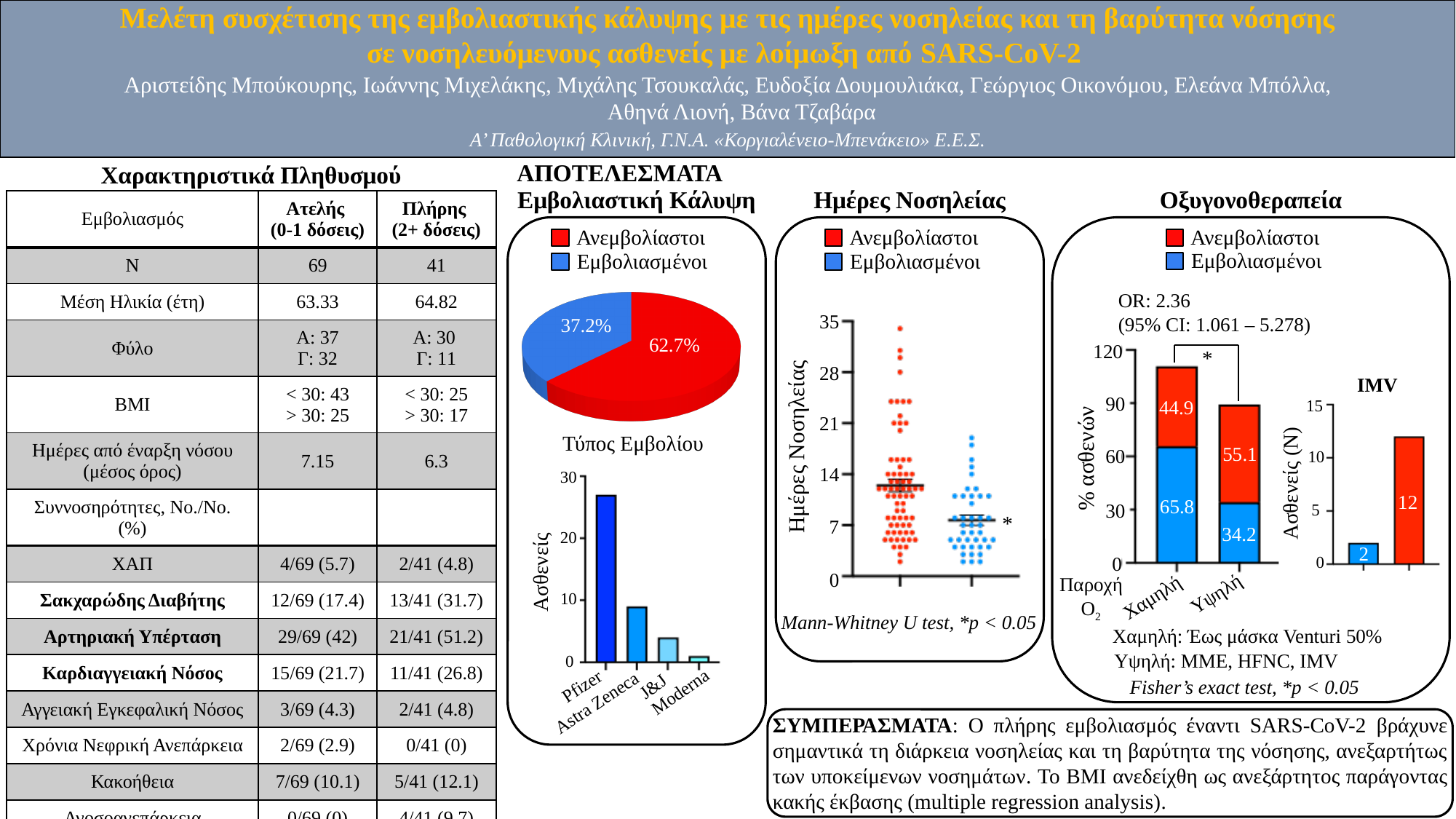
In the Τύπος Εμβολίου chart, is the value for Pfizer greater or less than 20? greater In the Εμβολιαστική Κάλυψη pie chart, what share of patients are Ανεμβολίαστοι? 62.7% How many series does the legend of the Ημέρες Νοσηλείας chart list? 2 In the Οξυγονοθεραπεία stacked bar chart, what is the value for Ανεμβολίαστοι in the Υψηλή bar? 55.1 In the Τύπος Εμβολίου chart, which vaccine type has the highest number of patients? Pfizer How many vaccine types are shown in the Τύπος Εμβολίου chart? 4 In the Εμβολιαστική Κάλυψη pie chart, what share of patients are Εμβολιασμένοι? 37.2% In the Οξυγονοθεραπεία stacked bar chart, what is the value for Εμβολιασμένοι in the Χαμηλή bar? 65.8 In the IMV chart, what is the difference between the Ανεμβολίαστοι and Εμβολιασμένοι values? 10 In the Τύπος Εμβολίου chart, is the value for Astra Zeneca greater or less than 10? less In the Τύπος Εμβολίου chart, which vaccine type has the lowest number of patients? Moderna In the Εμβολιαστική Κάλυψη pie chart, which colour represents the Ανεμβολίαστοι slice? Red